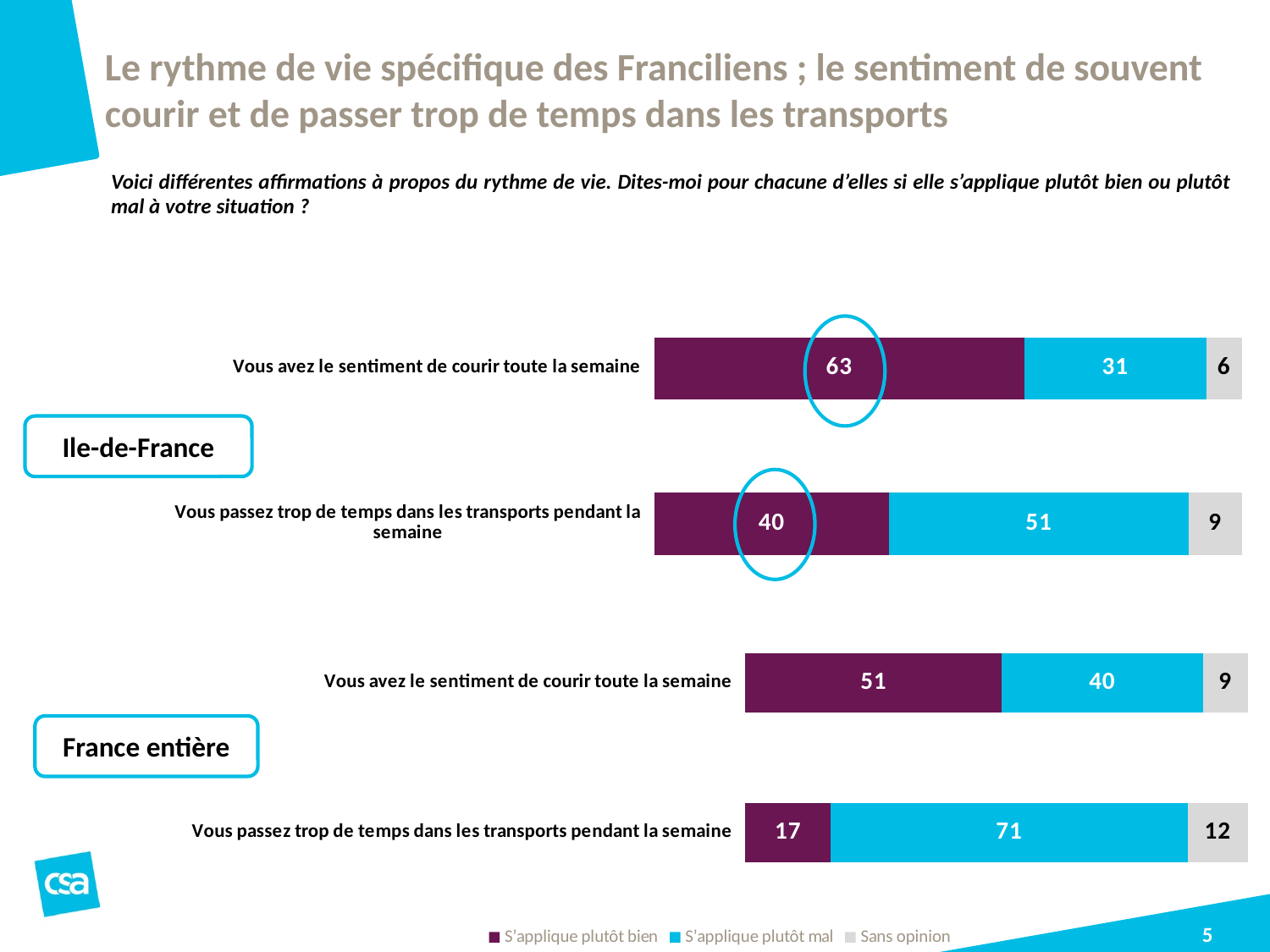
In the Ile-de-France chart, what is the value of "S'applique plutôt mal" for "Vous passez trop de temps dans les transports pendant la semaine"? 51 In the Ile-de-France chart, what is the value of "S'applique plutôt bien" for "Vous avez le sentiment de courir toute la semaine"? 63 In the Ile-de-France chart, what is the total of the stacked bar for "Vous passez trop de temps dans les transports pendant la semaine"? 100 How many series does the legend at the bottom of the slide list? 3 In the Ile-de-France chart, which statement has the higher "S'applique plutôt bien" value? Vous avez le sentiment de courir toute la semaine In the France entière chart, which is larger for "Vous avez le sentiment de courir toute la semaine": "S'applique plutôt bien" or "S'applique plutôt mal"? S'applique plutôt bien What kind of chart is used for the Ile-de-France data? Stacked bar chart In the France entière chart, what is the value of "Sans opinion" for "Vous passez trop de temps dans les transports pendant la semaine"? 12 In the France entière chart, which statement has the lowest "S'applique plutôt bien" value? Vous passez trop de temps dans les transports pendant la semaine In the France entière chart, what is the value of "S'applique plutôt bien" for "Vous avez le sentiment de courir toute la semaine"? 51 In the Ile-de-France chart, what is the difference between "S'applique plutôt bien" and "S'applique plutôt mal" for "Vous avez le sentiment de courir toute la semaine"? 32 In the France entière chart, what is the difference between "S'applique plutôt mal" and "S'applique plutôt bien" for "Vous passez trop de temps dans les transports pendant la semaine"? 54